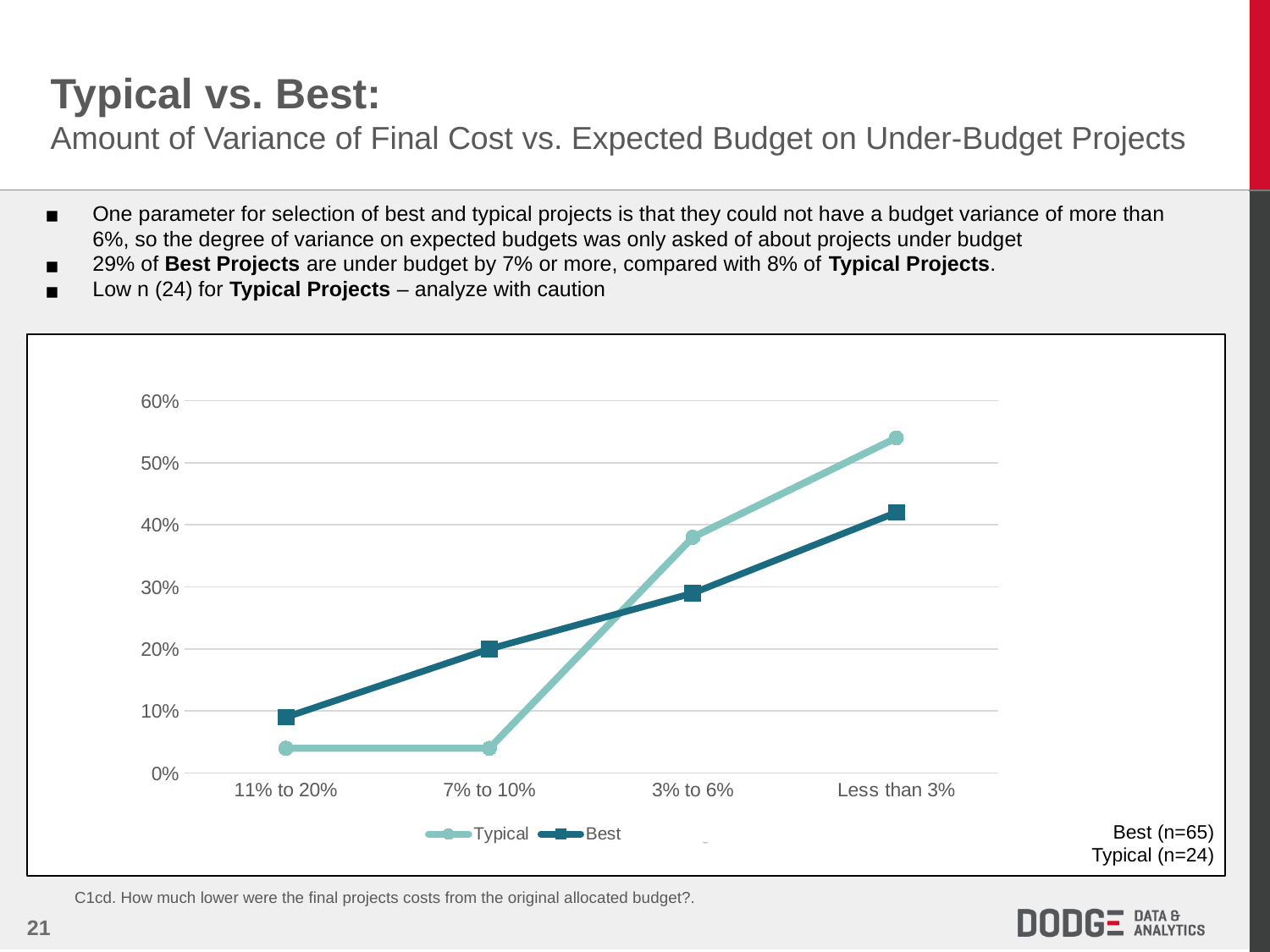
Is the value for Typical at 'Less than 3%' greater or less than 50%? greater At the 'Less than 3%' category, which series has the larger value, Typical or Best? Typical At the '7% to 10%' category, which series has the larger value, Typical or Best? Best Is the value for Best at 'Less than 3%' greater or less than 40%? greater How many series does the chart's legend list? 2 Does the Best series rise or fall moving from '11% to 20%' to 'Less than 3%' along the x axis? rise How many categories are shown along the x axis of the chart? 4 For the Best series, which category has the lowest value? 11% to 20% What kind of chart is shown on the slide? line chart Is the value for Typical at '11% to 20%' greater or less than 10%? less What are the two series names listed in the chart's legend? Typical and Best For the Typical series, which category has the highest value? Less than 3%